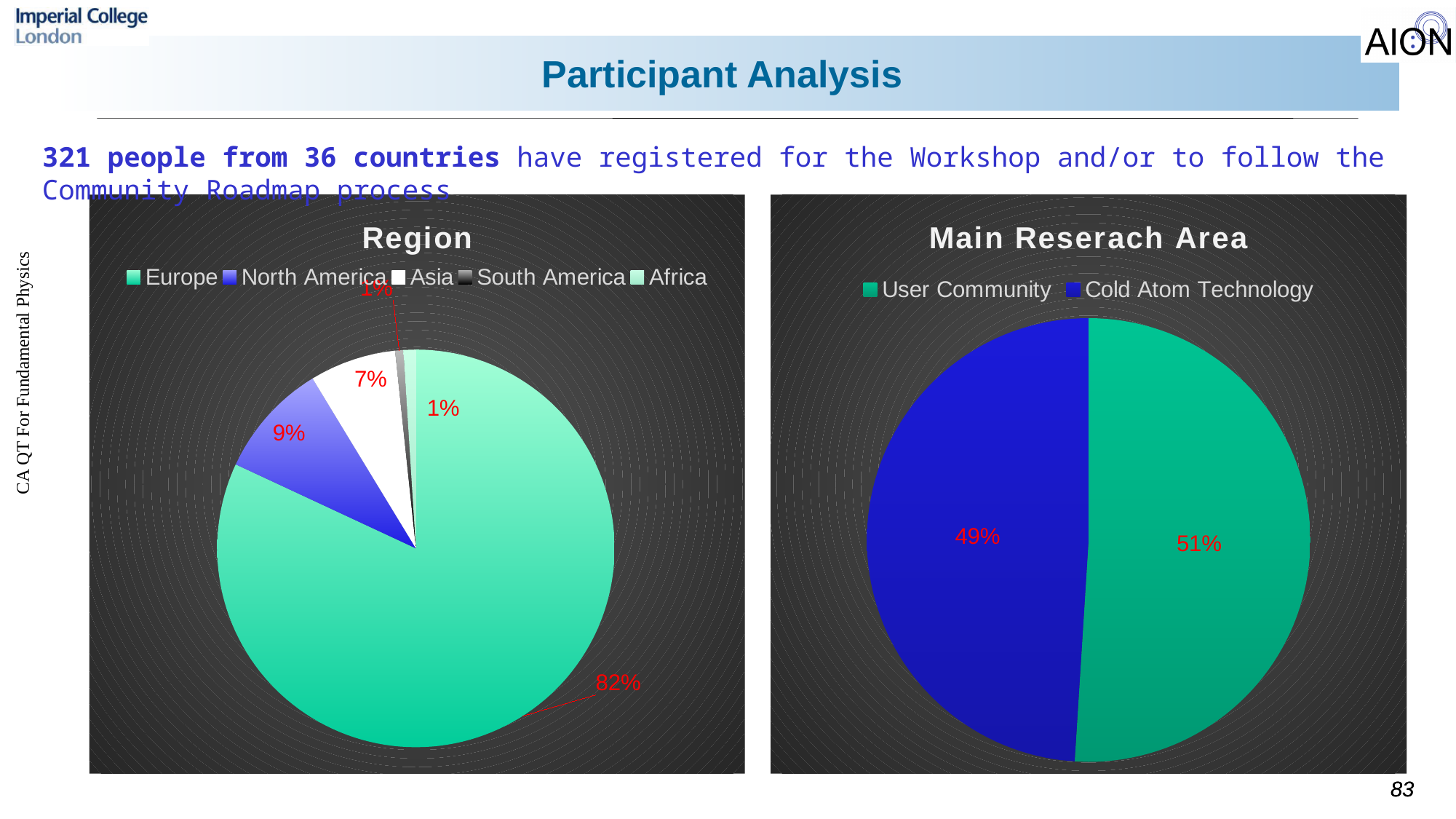
In the Region pie chart, which region has the largest share? Europe In the Region pie chart, how many regions are listed in the legend? 5 In the Region pie chart, what share of participants are from Europe? 82% What type of chart is the Main Reserach Area chart? Pie chart In the Main Reserach Area pie chart, what share is Cold Atom Technology? 49% In the Region pie chart, what percentage is shown for North America? 9% In the Region pie chart, what percentage is shown for Africa? 1% In the Main Reserach Area pie chart, what share is User Community? 51% In the Region pie chart, what percentage is shown for Asia? 7% In the Main Reserach Area pie chart, which is larger, User Community or Cold Atom Technology? User Community In the Main Reserach Area pie chart, what colour is the Cold Atom Technology slice? Blue In the Region pie chart, what is the difference in percentage points between Europe and North America? 73